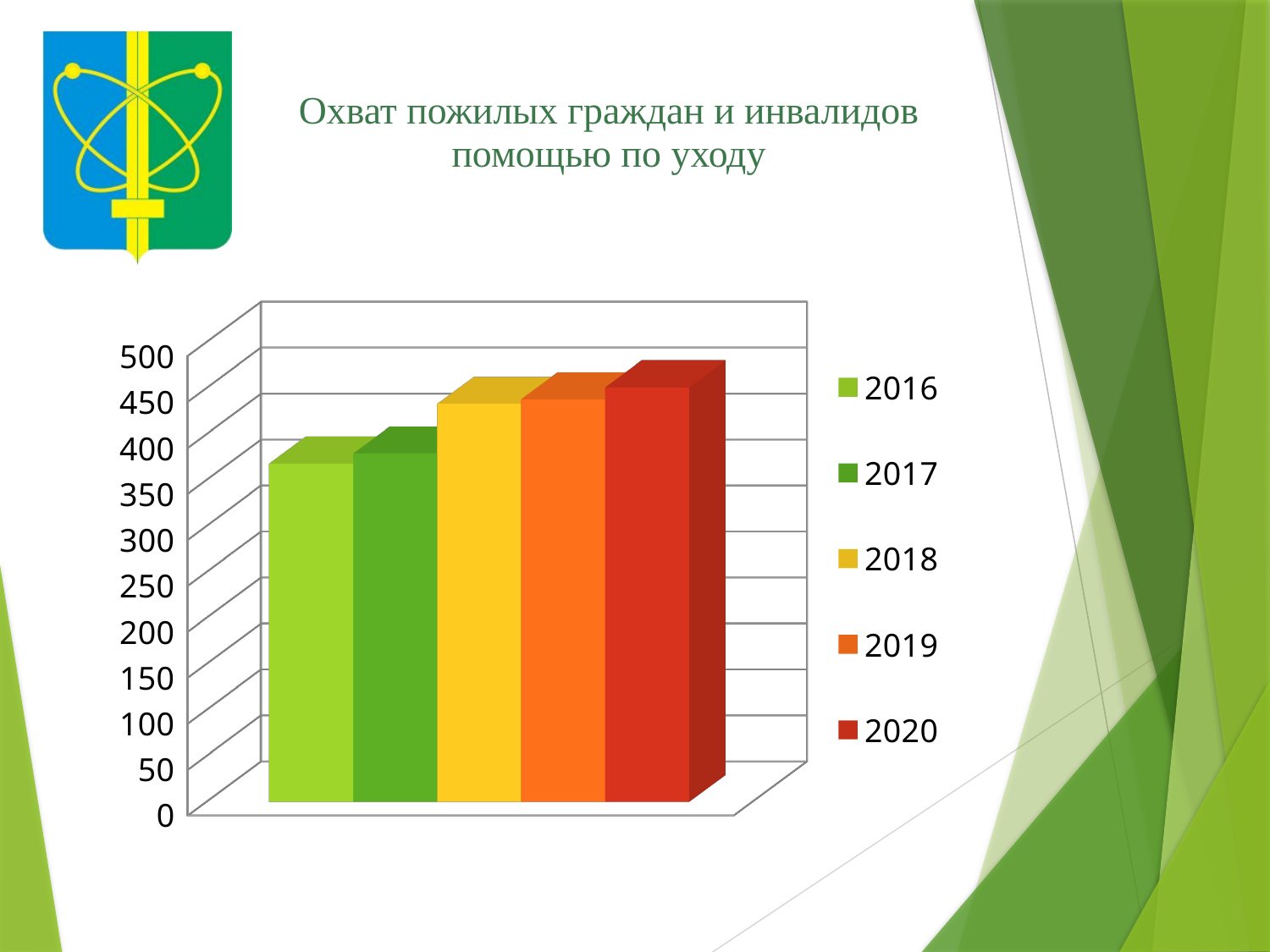
How many bars are plotted in the chart? 5 What is the title of the slide above the chart? Охват пожилых граждан и инвалидов помощью по уходу What kind of chart is shown on the slide? bar chart Which year has the highest bar in the chart? 2020 Is the value for 2018 greater or less than 400? greater How many entries does the chart legend list? 5 Do the values rise or fall from 2016 to 2020? rise Which year has the lowest bar in the chart? 2016 Which is larger, the value for 2018 or the value for 2016? 2018 Is the value for 2016 greater or less than 350? greater Is the value for 2020 greater or less than 500? less